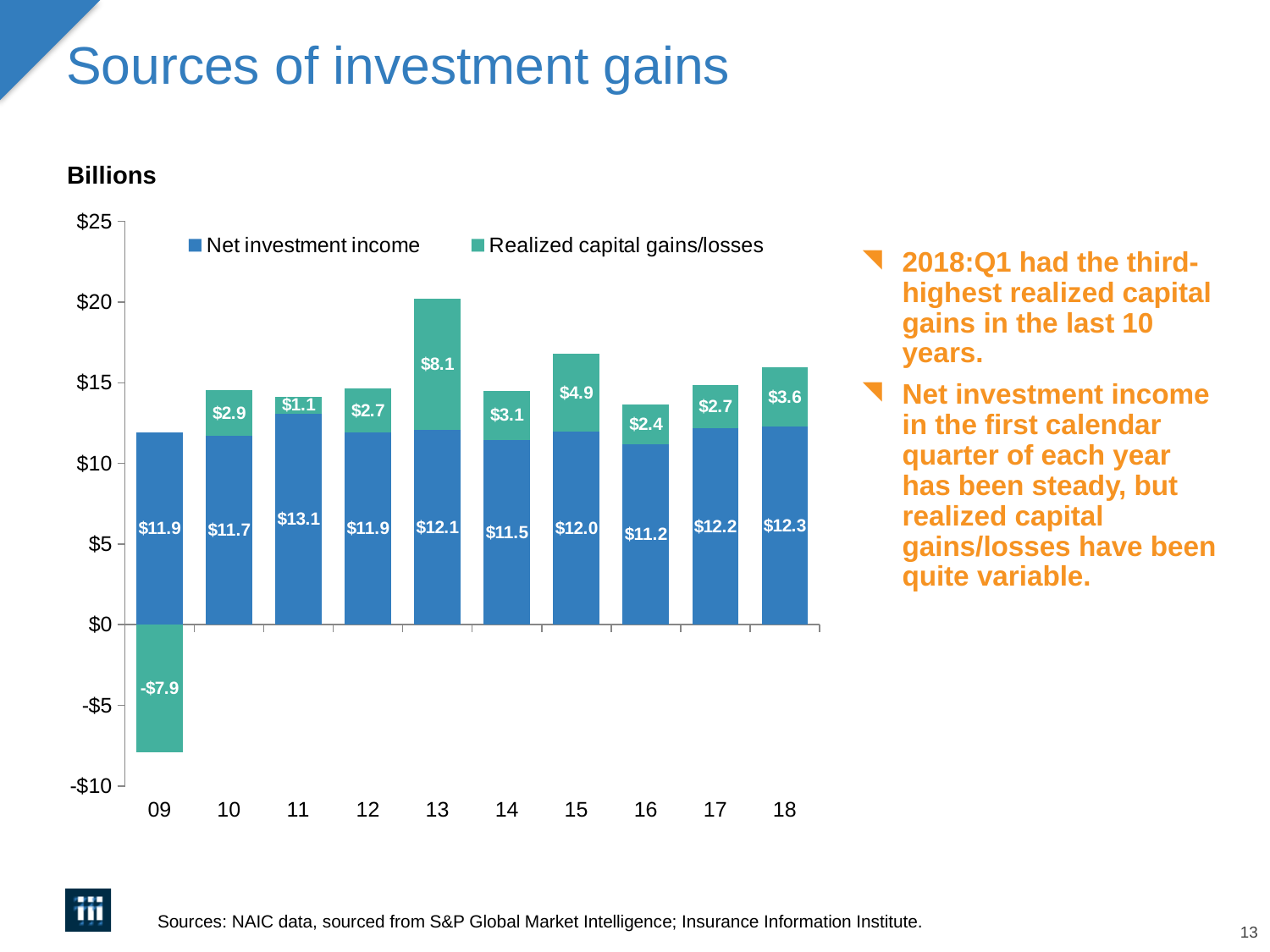
What unit is stated above the chart? Billions Which year has the lowest net investment income? 16 What is the realized capital gains/losses value for 2018? $3.6 What is the difference between realized capital gains in 2013 and 2015? $3.2 How many series does the legend list? 2 How many years are shown on the x axis? 10 What is the net investment income for 2013? $12.1 Which is larger, net investment income in 2011 or in 2017? 2011 What is the realized capital gains/losses value for 2009? -$7.9 Which year has the highest realized capital gains? 13 What kind of chart is shown on the slide? Stacked bar chart What is the total of the stacked bar for 2013? $20.2